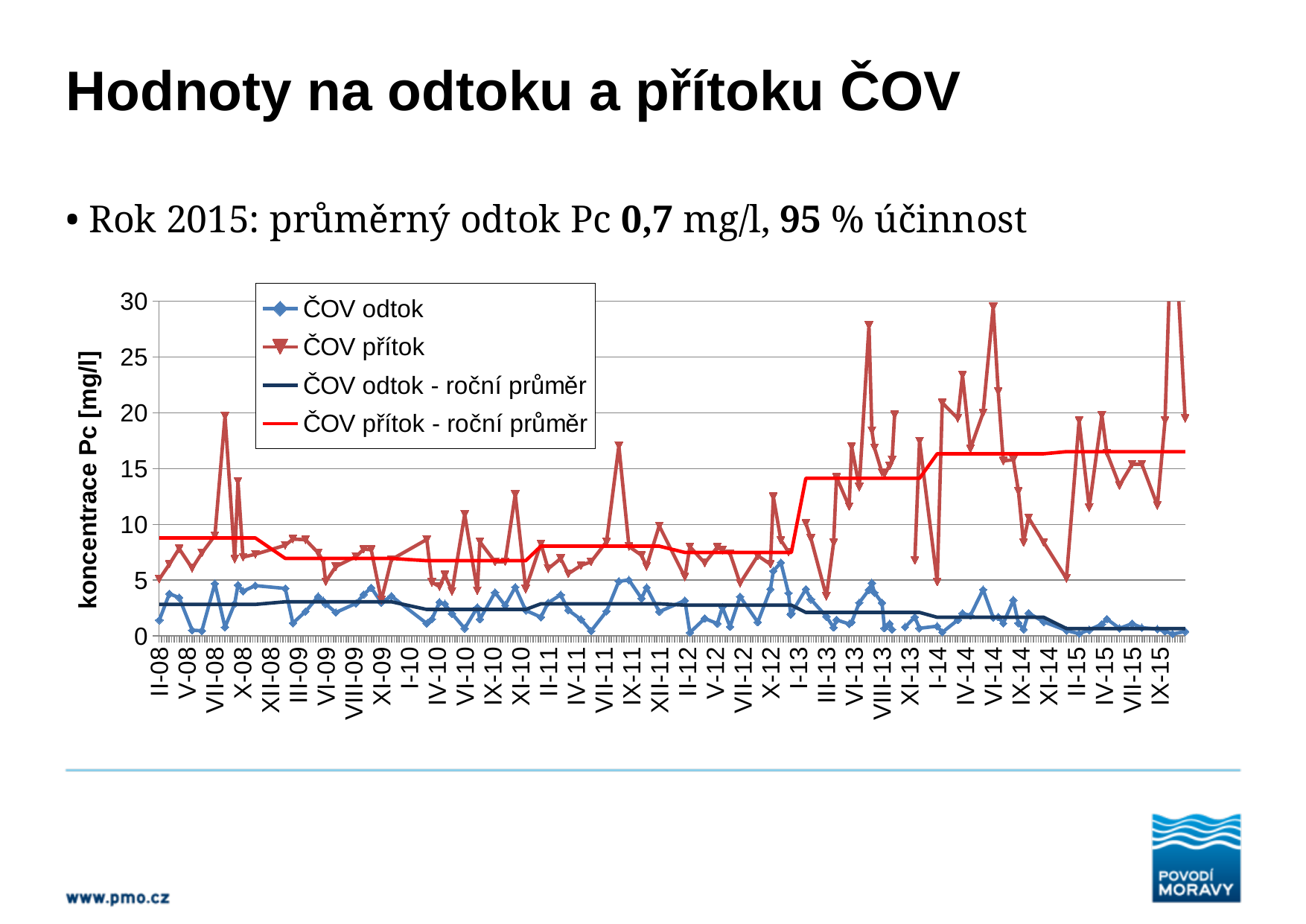
What kind of chart is shown on the slide? line chart Which series reaches the highest values on the chart? ČOV přítok Is the value of the ČOV přítok - roční průměr line in 2014 greater or less than 15? greater Does the ČOV odtok - roční průměr line generally rise or fall from 2008 to 2015? fall What is the label of the vertical axis of the chart? koncentrace Pc [mg/l] Does the ČOV přítok - roční průměr line generally rise or fall from 2008 to 2015? rise Is the value of the ČOV odtok - roční průměr line in 2015 greater or less than 5? less How many series does the chart legend list? 4 Is the value of the ČOV přítok - roční průměr line in 2008 greater or less than 10? less Which series in the legend is drawn in red without markers? ČOV přítok - roční průměr Which is higher throughout the chart, the ČOV přítok - roční průměr line or the ČOV odtok - roční průměr line? ČOV přítok - roční průměr